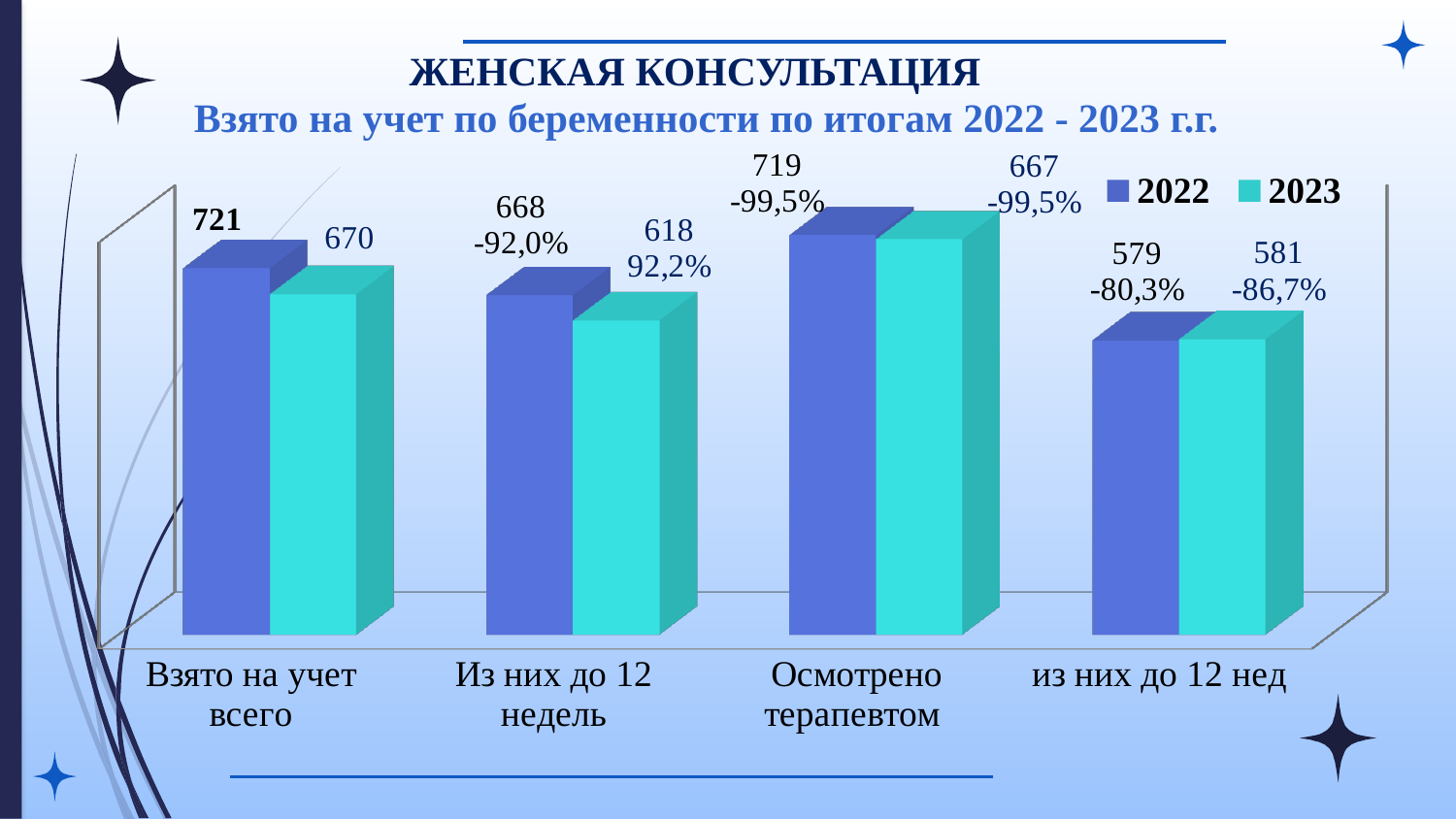
For "Из них до 12 недель", which is larger: the 2022 value or the 2023 value? 2022 What is the 2023 value for "Из них до 12 недель"? 618 What is the difference between the 2022 and 2023 values for "Осмотрено терапевтом"? 52 What is the 2022 value for "Осмотрено терапевтом"? 719 What is the 2023 value for "Взято на учет всего"? 670 What kind of chart is shown on the slide? bar chart What is the difference between the 2022 and 2023 values for "Взято на учет всего"? 51 What is the 2022 value for "Взято на учет всего"? 721 What is the 2023 value for "из них до 12 нед"? 581 How many series does the legend list? 2 Which category has the lowest 2022 value? из них до 12 нед